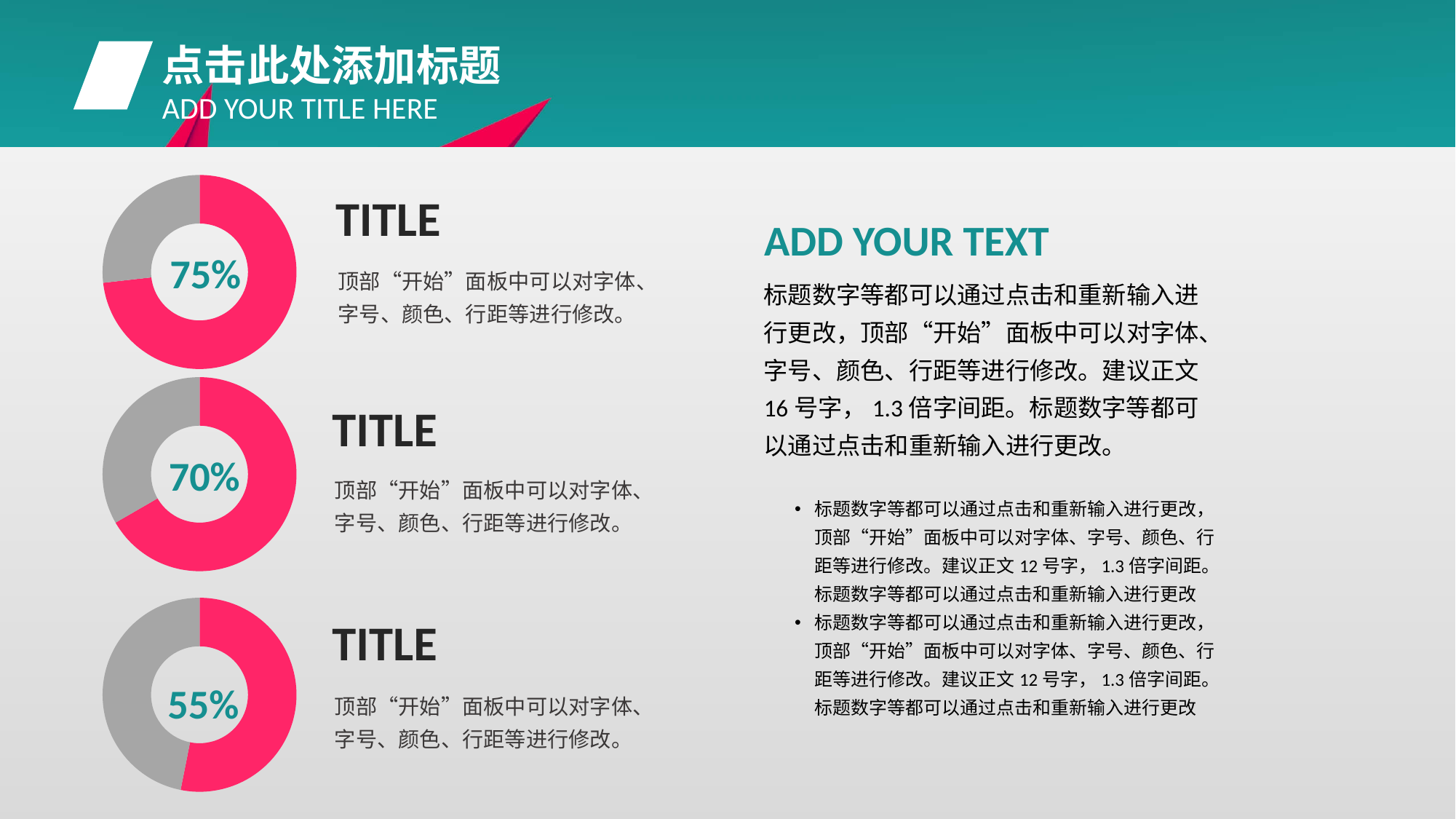
What percentage is shown in the centre of the middle donut chart? 70% What percentage is shown in the centre of the top donut chart? 75% What colour is used for the filled (percentage) portion of each donut chart? Pink/magenta What kind of chart is used on the left side of the slide? Donut (ring) chart What percentage is shown in the centre of the bottom donut chart? 55% What is the difference between the percentage in the top donut chart and the percentage in the bottom donut chart? 20% What is the difference between the percentage in the top donut chart and the percentage in the middle donut chart? 5% Is the value shown in the bottom donut chart greater or less than 50%? greater How many donut charts are on the slide? 3 Which is larger, the percentage in the middle donut chart or the percentage in the bottom donut chart? The middle donut chart (70%) Which of the three donut charts shows the highest percentage? The top one (75%) Which of the three donut charts shows the lowest percentage? The bottom one (55%)